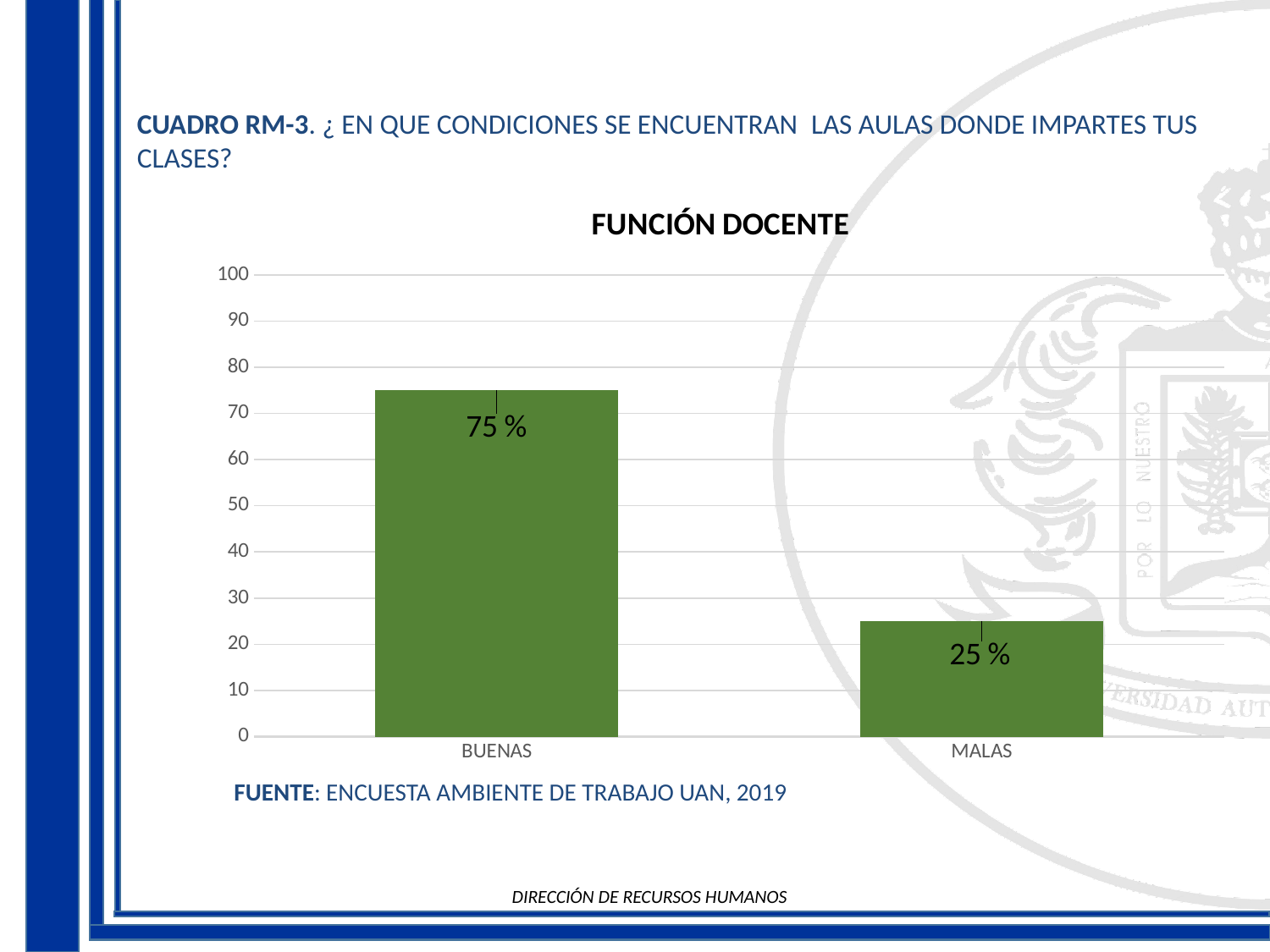
Is the value for BUENAS greater or less than 70? greater Which is larger, the value for BUENAS or the value for MALAS? BUENAS What is the value for BUENAS? 75 % Which category has the lowest value? MALAS What is the difference between the values for BUENAS and MALAS? 50 % How many categories are shown on the x axis? 2 What kind of chart is shown on the slide? bar chart What is the maximum value shown on the y axis? 100 Which category has the highest value? BUENAS Is the value for MALAS greater or less than 30? less What is the title of the chart? FUNCIÓN DOCENTE What is the value for MALAS? 25 %